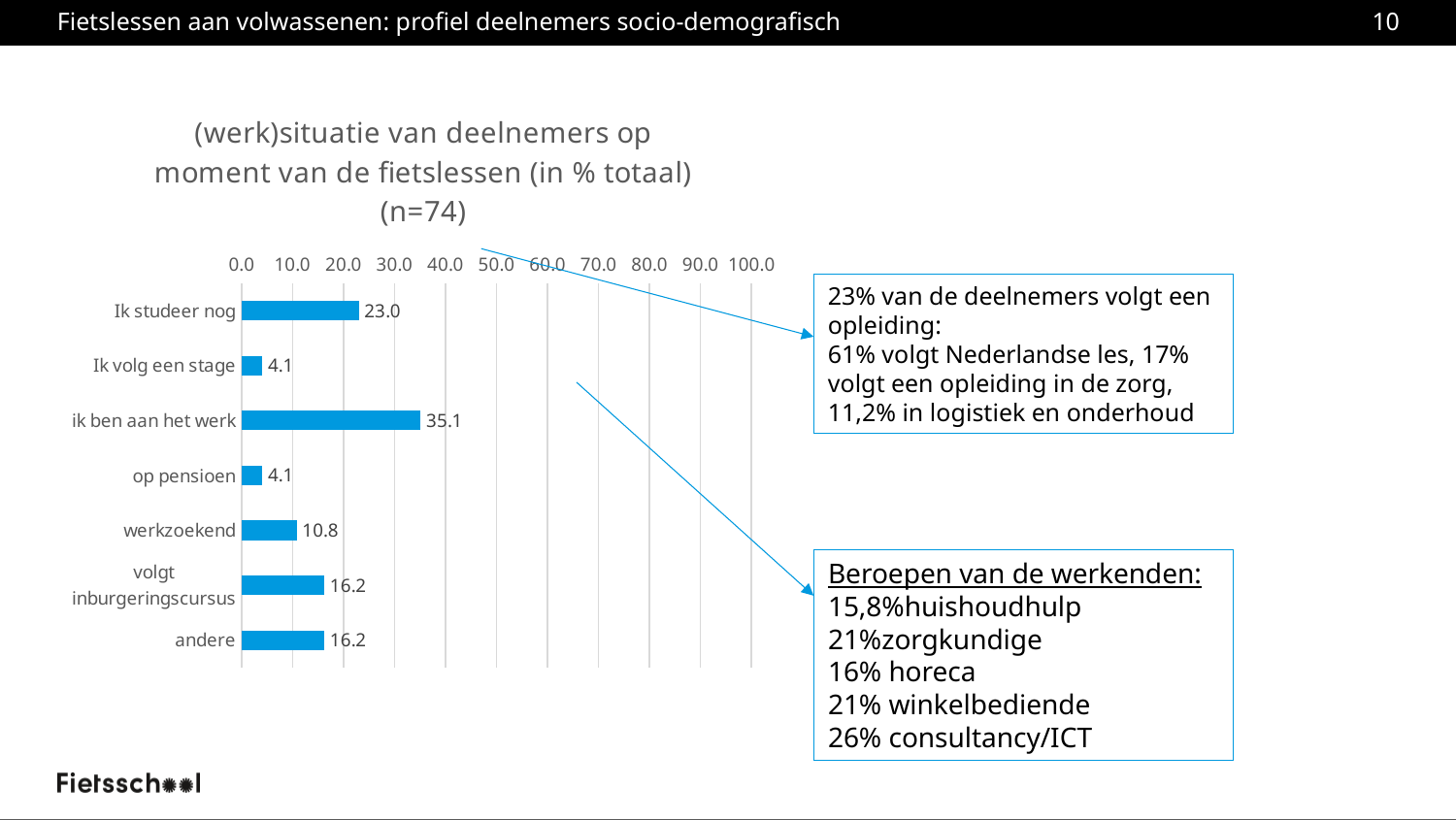
What is the value for 'volgt inburgeringscursus'? 16.2 How many categories are shown in the chart? 7 What is the value for 'ik ben aan het werk'? 35.1 What is the value for 'werkzoekend'? 10.8 What is the sample size (n) stated in the chart title? 74 Which category has the highest value? ik ben aan het werk What kind of chart is shown on the slide? bar chart Is the value for 'ik ben aan het werk' greater or less than 30.0? greater What is the highest value shown on the chart's axis? 100.0 Which is larger, the value for 'werkzoekend' or the value for 'andere'? andere What is the difference between the values for 'ik ben aan het werk' and 'Ik studeer nog'? 12.1 What is the value for 'Ik studeer nog'? 23.0